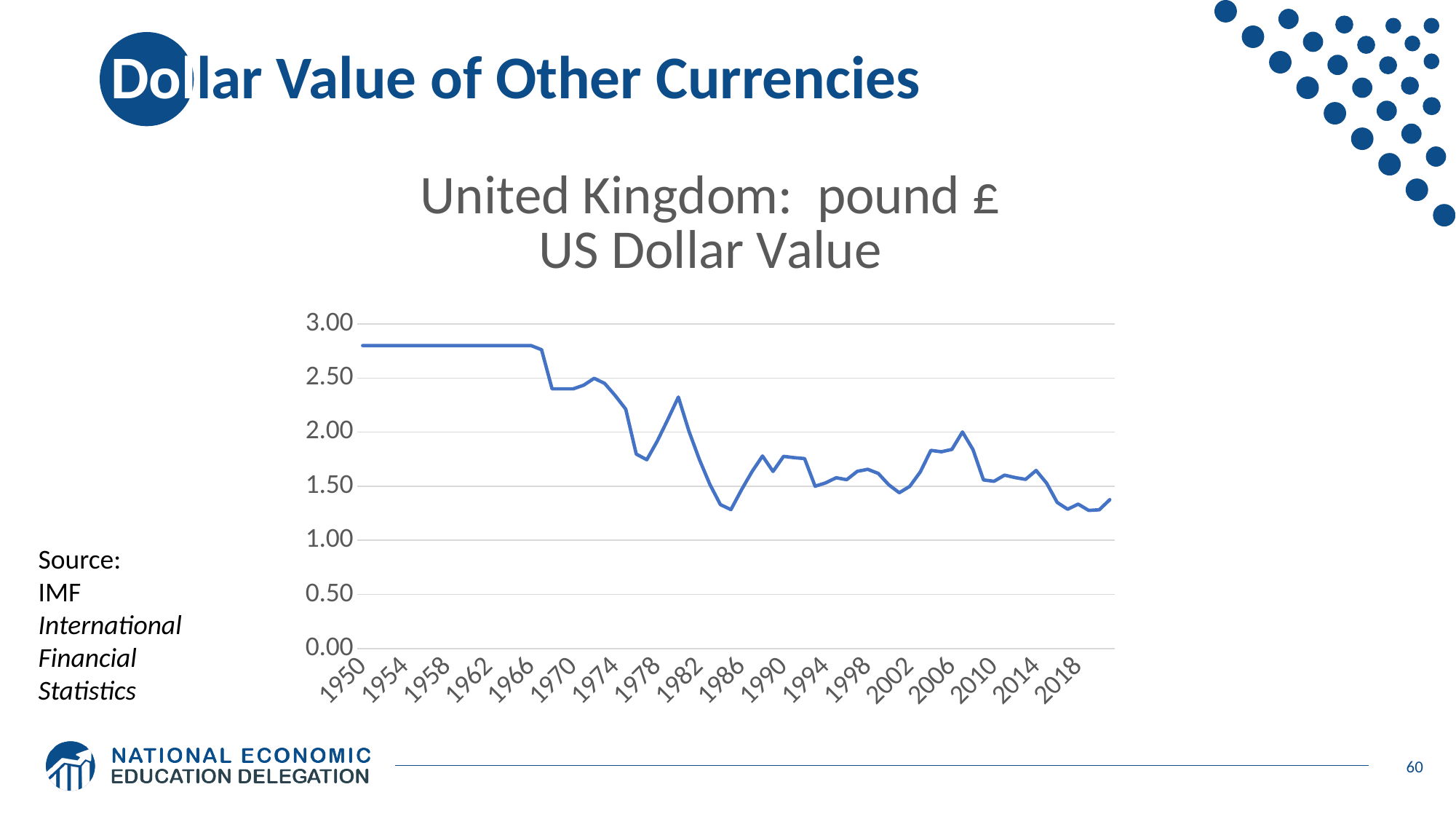
Is the value for 2018 greater or less than 1.50? less What is the highest value shown on the y axis? 3.00 Which year has the larger value, 1950 or 2018? 1950 Is the value for 1970 greater or less than 2.00? greater Is the value for 1978 greater or less than 1.50? greater What kind of chart is shown on the slide? line chart Overall, does the US dollar value of the pound rise or fall from 1950 to 2018? fall What is the title of the chart? United Kingdom: pound £ US Dollar Value How many year labels are shown on the x axis? 18